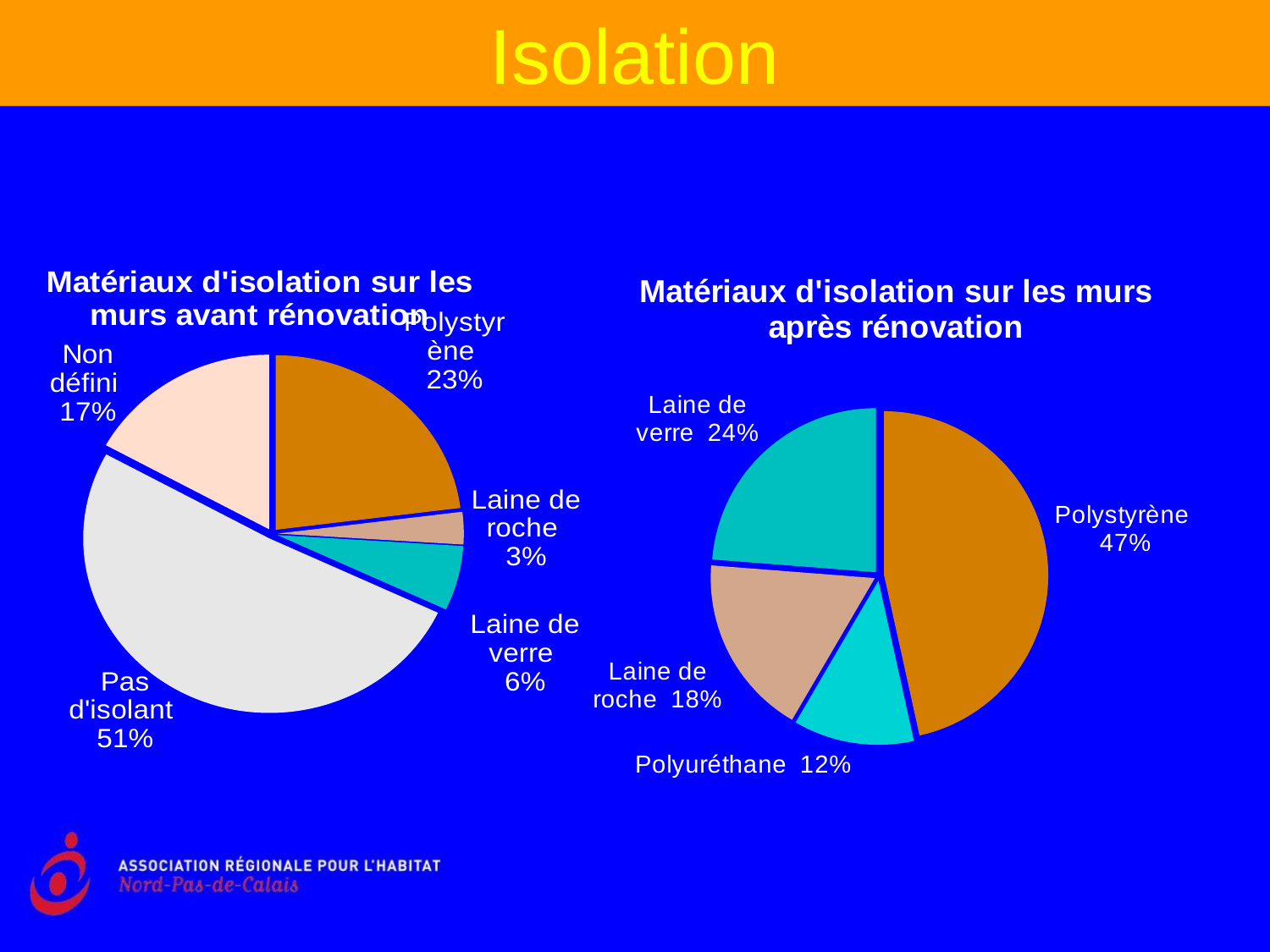
In the chart 'Matériaux d'isolation sur les murs avant rénovation', what share is 'Polystyrène'? 23% In the chart 'Matériaux d'isolation sur les murs après rénovation', which category has the largest share? Polystyrène In the chart 'Matériaux d'isolation sur les murs avant rénovation', what share is 'Pas d'isolant'? 51% In the chart 'Matériaux d'isolation sur les murs avant rénovation', how many slices does the pie have? 5 In the chart 'Matériaux d'isolation sur les murs avant rénovation', which category has the smallest share? Laine de roche In the chart 'Matériaux d'isolation sur les murs avant rénovation', which category has the largest share? Pas d'isolant In the chart 'Matériaux d'isolation sur les murs avant rénovation', what is the difference between 'Non défini' and 'Laine de verre'? 11% In the chart 'Matériaux d'isolation sur les murs après rénovation', how many slices does the pie have? 4 In the chart 'Matériaux d'isolation sur les murs après rénovation', what share is 'Polyuréthane'? 12% In the chart 'Matériaux d'isolation sur les murs après rénovation', which is larger, 'Laine de verre' or 'Laine de roche'? Laine de verre What type of chart is 'Matériaux d'isolation sur les murs après rénovation'? Pie chart In the chart 'Matériaux d'isolation sur les murs après rénovation', what share is 'Polystyrène'? 47%